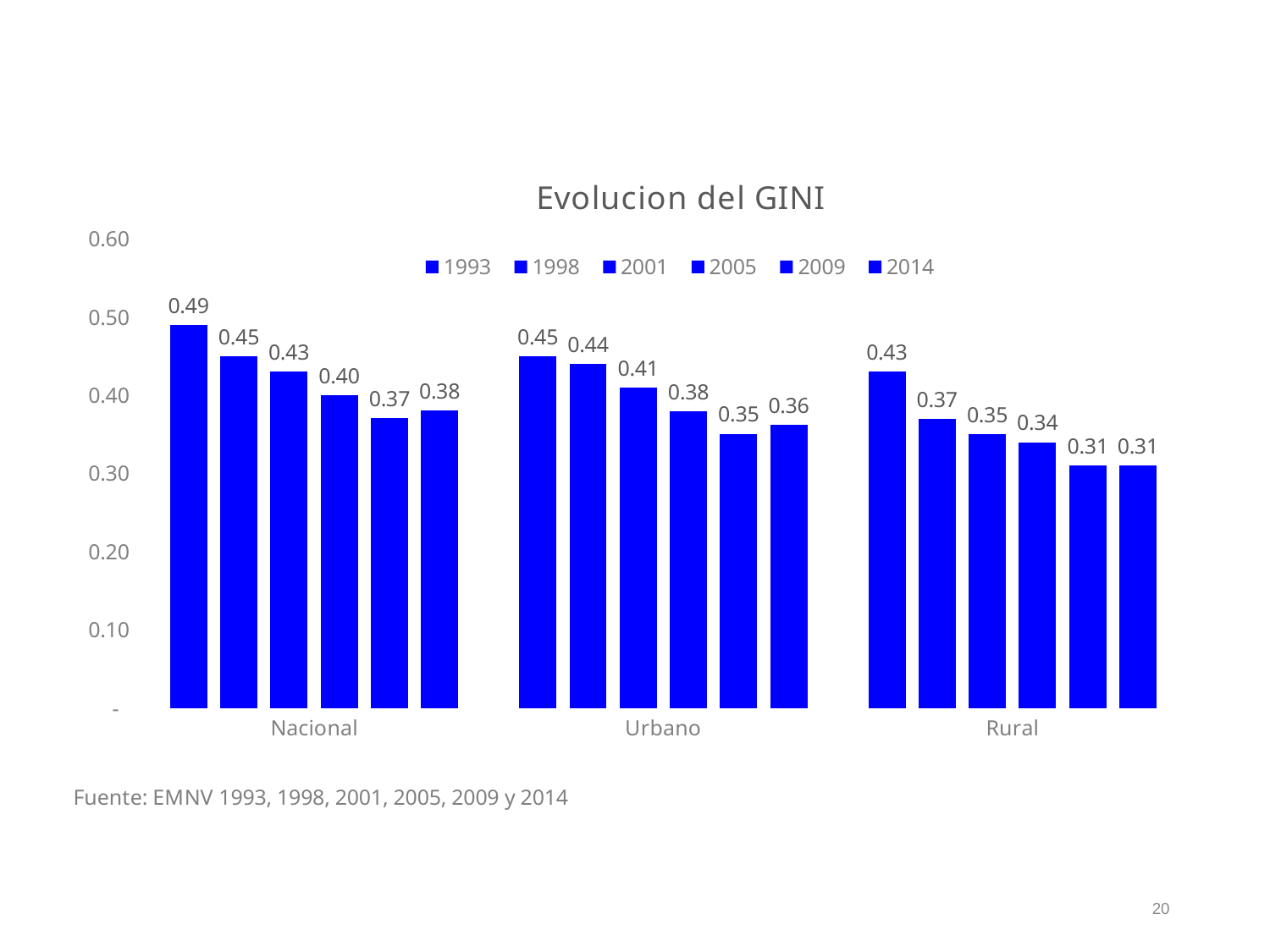
How many series does the legend list? 6 Which is larger, the Urbano value in 1998 or the Rural value in 1993? Urbano in 1998 Which category has the lowest value in 2009? Rural What is the value for Rural in 2014? 0.31 What is the value for Urbano in 2001? 0.41 How many categories are shown on the x axis? 3 What is the difference between the Nacional values for 1993 and 2014? 0.11 What is the value for Nacional in 1993? 0.49 Which category has the highest value in 1993? Nacional What kind of chart is shown on the slide? bar chart What is the title of the chart? Evolucion del GINI Do the Rural values rise or fall from 1993 to 2014? fall